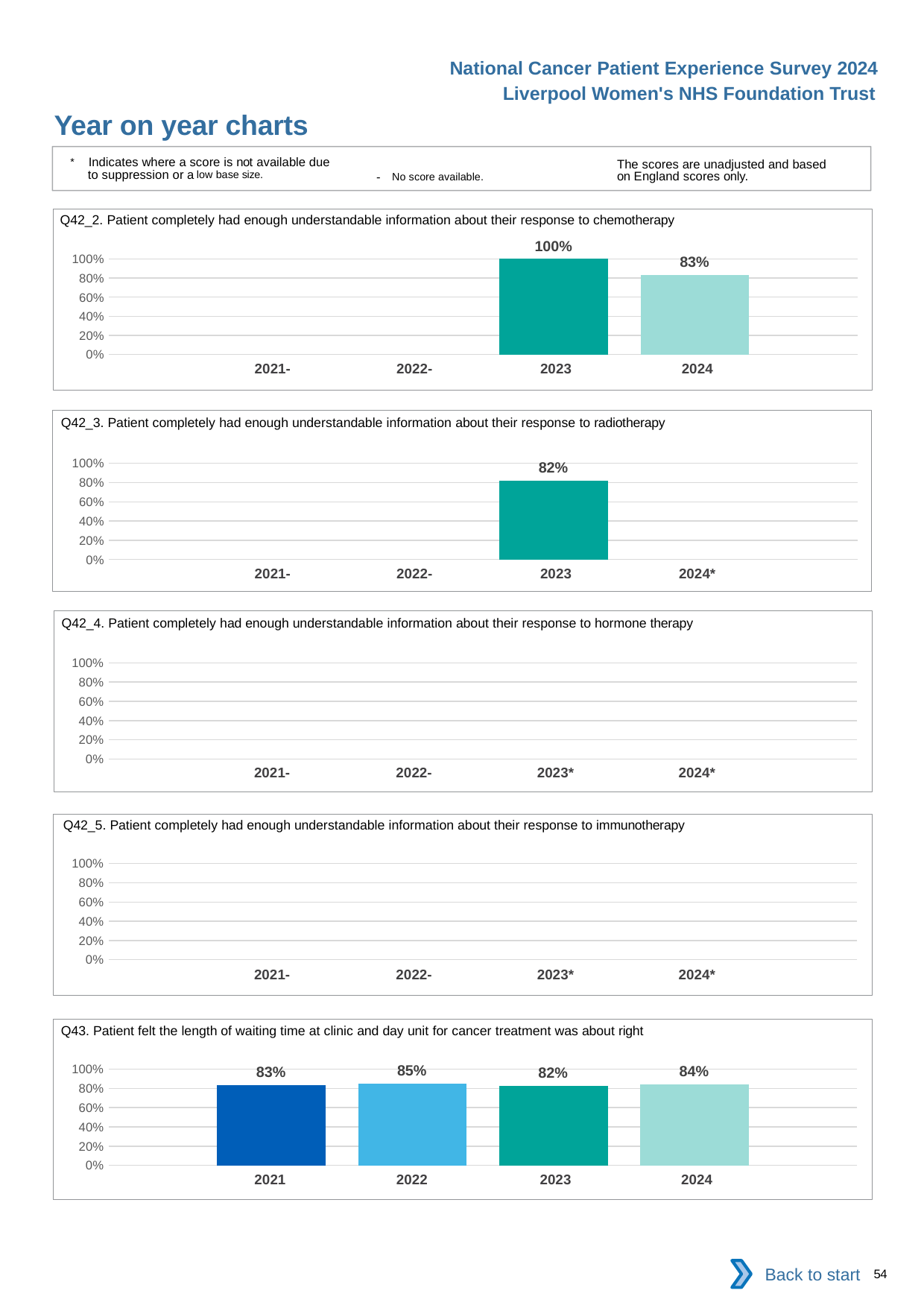
How many bars are plotted in the Q43 chart (waiting time at clinic and day unit)? 4 In the Q43 chart (waiting time at clinic and day unit), what is the value for 2021? 83% In the Q42_2 chart (chemotherapy), what is the difference between the 2023 and 2024 values? 17% In the Q43 chart (waiting time at clinic and day unit), which year has the lowest value? 2023 What type of chart is the Q43 chart (waiting time at clinic and day unit)? Bar chart In the Q43 chart (waiting time at clinic and day unit), what is the difference between the 2022 and 2023 values? 3% In the Q42_2 chart (chemotherapy), what is the value for 2023? 100% In the Q42_2 chart (chemotherapy), what is the value for 2024? 83% In the Q42_3 chart (radiotherapy), is the value for 2023 greater or less than 60%? greater In the Q42_3 chart (radiotherapy), what is the value for 2023? 82% In the Q43 chart (waiting time at clinic and day unit), which is larger, the value for 2022 or the value for 2024? 2022 In the Q43 chart (waiting time at clinic and day unit), which year has the highest value? 2022